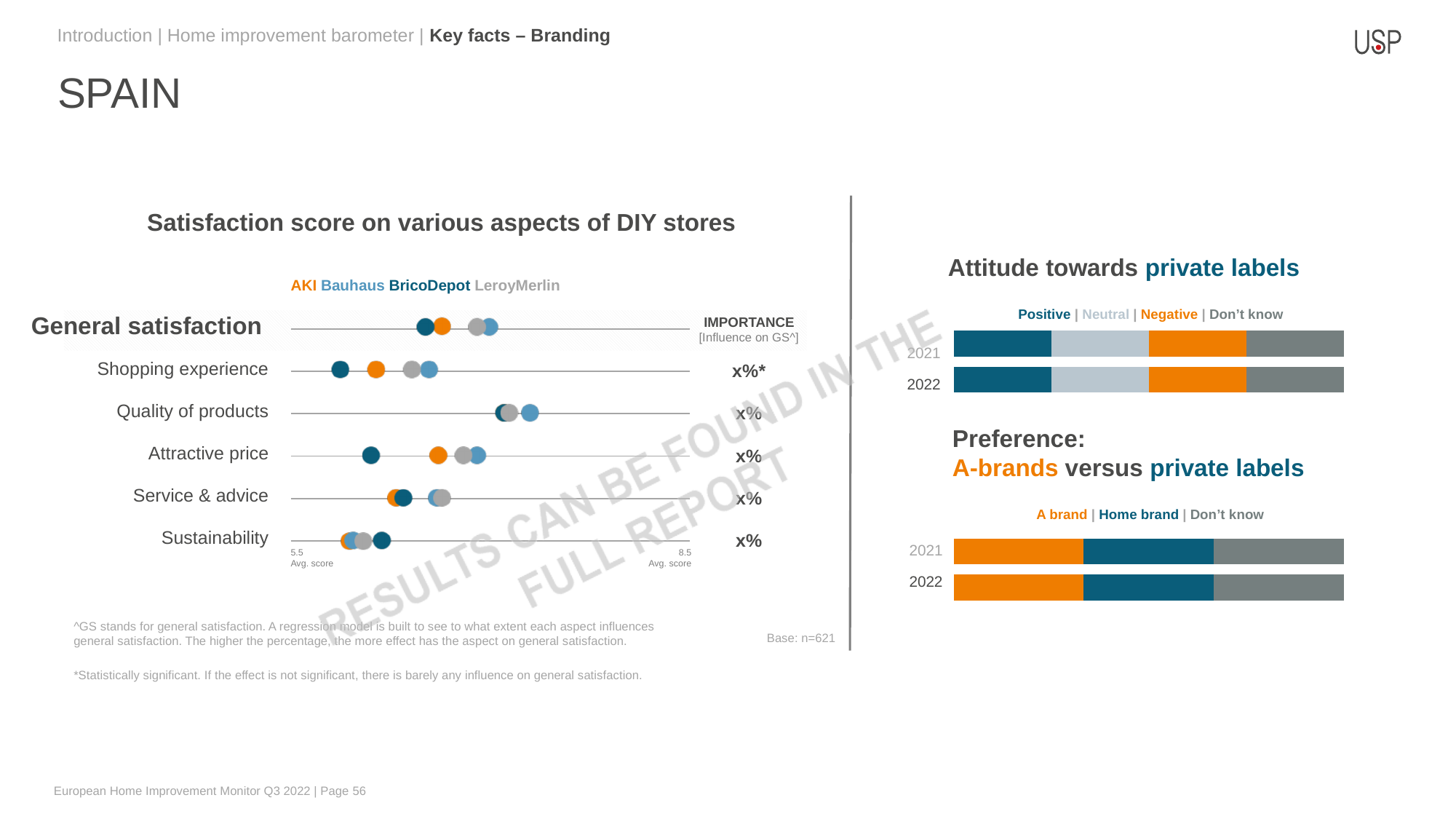
How many series does the legend of the 'Preference: A-brands versus private labels' chart list? 3 In the 'Satisfaction score on various aspects of DIY stores' chart, which store scores lower on Attractive price, BricoDepot or AKI? BricoDepot How many years are shown in the 'Preference: A-brands versus private labels' chart? 2 What kind of chart is 'Satisfaction score on various aspects of DIY stores'? Dot plot How many aspects (categories) are listed in the 'Satisfaction score on various aspects of DIY stores' chart? 6 In the 'Satisfaction score on various aspects of DIY stores' chart, which store has the highest score for Quality of products? Bauhaus What are the minimum and maximum average scores shown on the axis of the 'Satisfaction score on various aspects of DIY stores' chart? 5.5 and 8.5 How many series does the legend of the 'Attitude towards private labels' chart list? 4 In the 'Satisfaction score on various aspects of DIY stores' chart, which store has the lowest score for Shopping experience? BricoDepot In the 'Satisfaction score on various aspects of DIY stores' chart, which store scores higher on Sustainability, AKI or BricoDepot? BricoDepot How many store brands does the legend of the 'Satisfaction score on various aspects of DIY stores' chart list? 4 What kind of chart is 'Attitude towards private labels'? Stacked bar chart